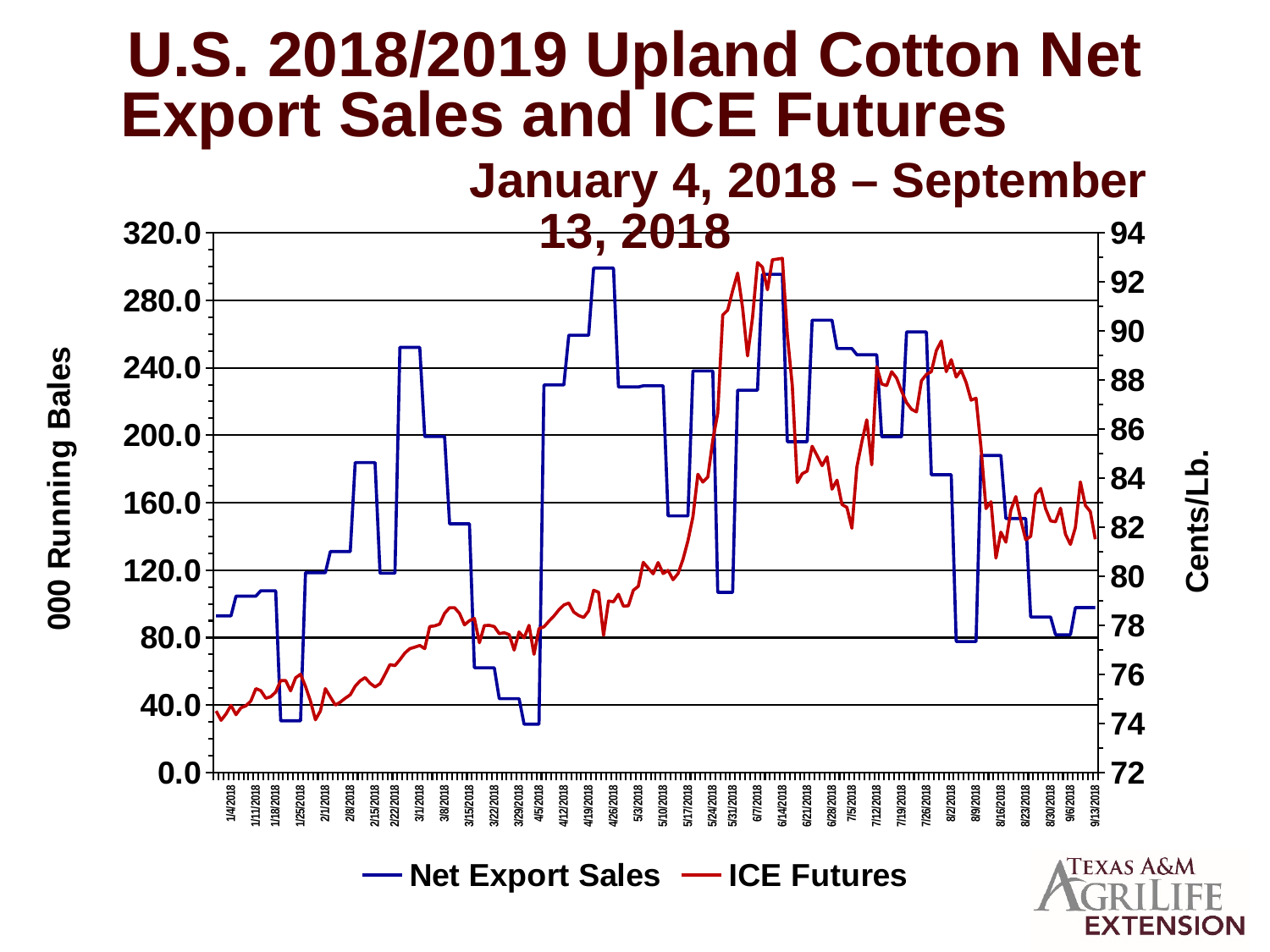
What kind of chart is shown on the slide? line chart Do ICE Futures generally rise or fall from January 2018 to early June 2018? rise What is the label on the right-hand vertical axis? Cents/Lb. Which is larger: Net Export Sales in late April 2018 or Net Export Sales on 9/13/2018? late April 2018 How many series does the legend list? 2 Is the ICE Futures value on 1/4/2018 greater or less than 76? less Is the ICE Futures value on 9/13/2018 greater or less than 84? less Is the highest ICE Futures value in June 2018 greater or less than 92? greater What are the two series named in the legend? Net Export Sales and ICE Futures